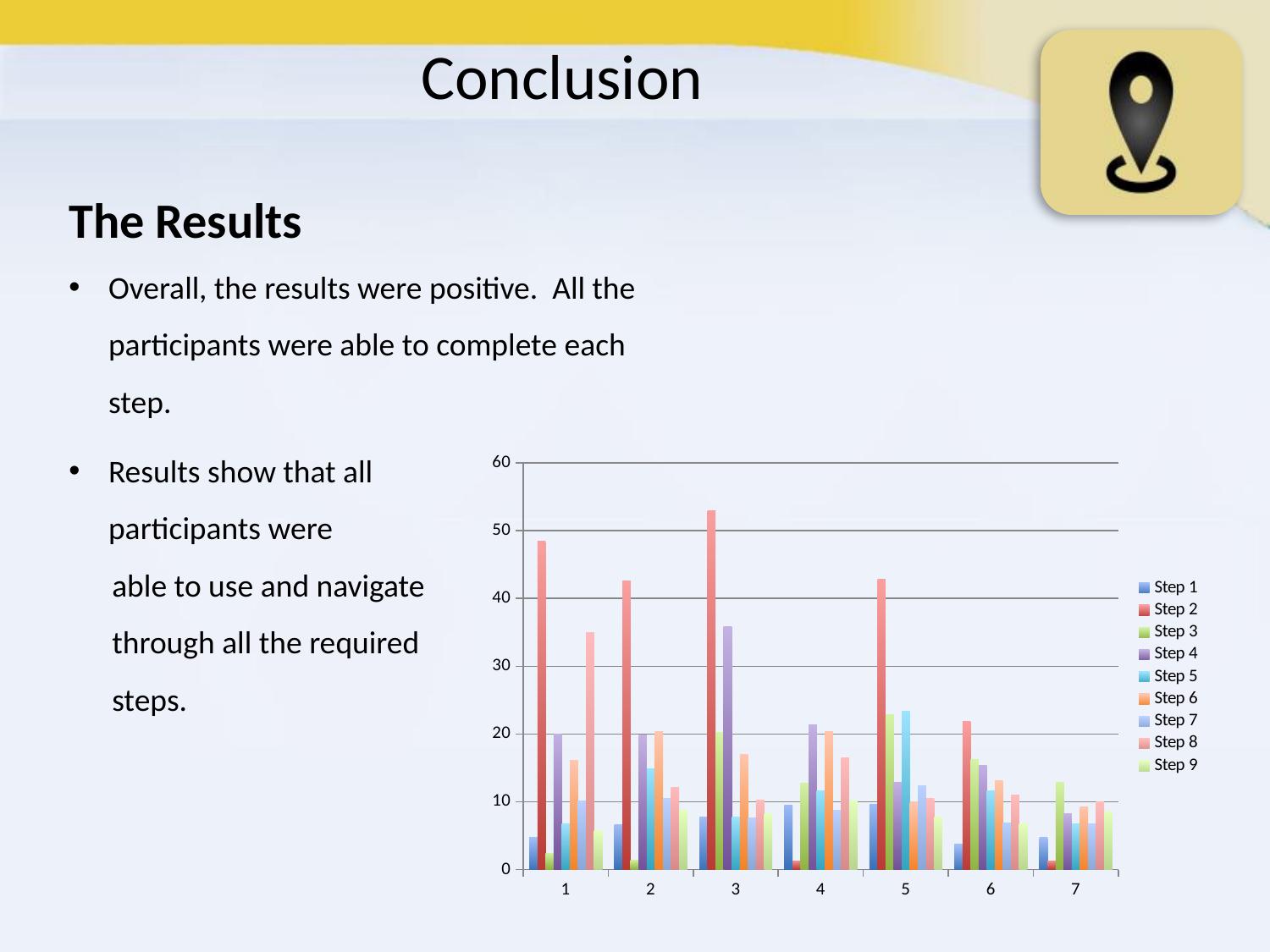
What is the first series listed in the chart's legend? Step 1 Is the value for Step 2 in category 1 greater or less than 40? greater Which is larger in category 5: the value for Step 2 or the value for Step 3? Step 2 Is the value for Step 2 in category 3 greater or less than 50? greater What kind of chart is shown on the slide? bar chart Is the value for Step 4 in category 3 greater or less than 30? greater How many categories are shown along the x axis of the chart? 7 How many series does the chart's legend list? 9 Which is larger in category 1: the value for Step 8 or the value for Step 4? Step 8 In which category is the Step 2 bar the tallest? 3